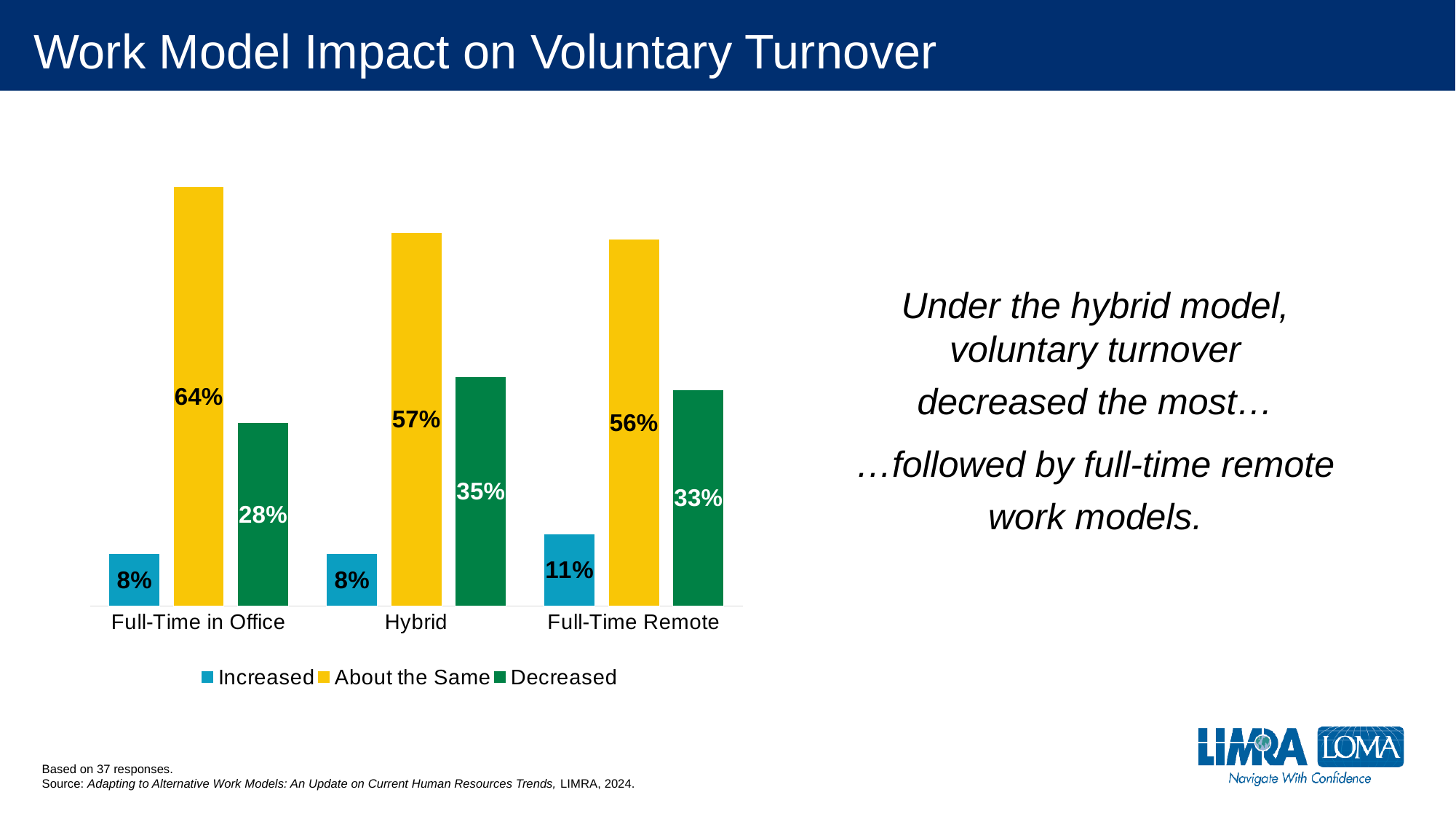
What is the 'Decreased' value for the Hybrid work model? 35% Which work model has the lowest 'About the Same' value? Full-Time Remote How many work model categories are shown on the x axis? 3 Which is larger: the 'Decreased' value for Hybrid or for Full-Time Remote? Hybrid What is the difference between the 'About the Same' and 'Decreased' values for Full-Time in Office? 36% What kind of chart is shown on the slide? Bar chart Which legend entry is shown in yellow? About the Same How many series does the legend list? 3 Which work model has the highest 'Decreased' value? Hybrid What is the 'Increased' value for Full-Time Remote? 11% What is the title of the slide containing the chart? Work Model Impact on Voluntary Turnover What percentage of respondents reported voluntary turnover 'About the Same' under the Full-Time in Office model? 64%